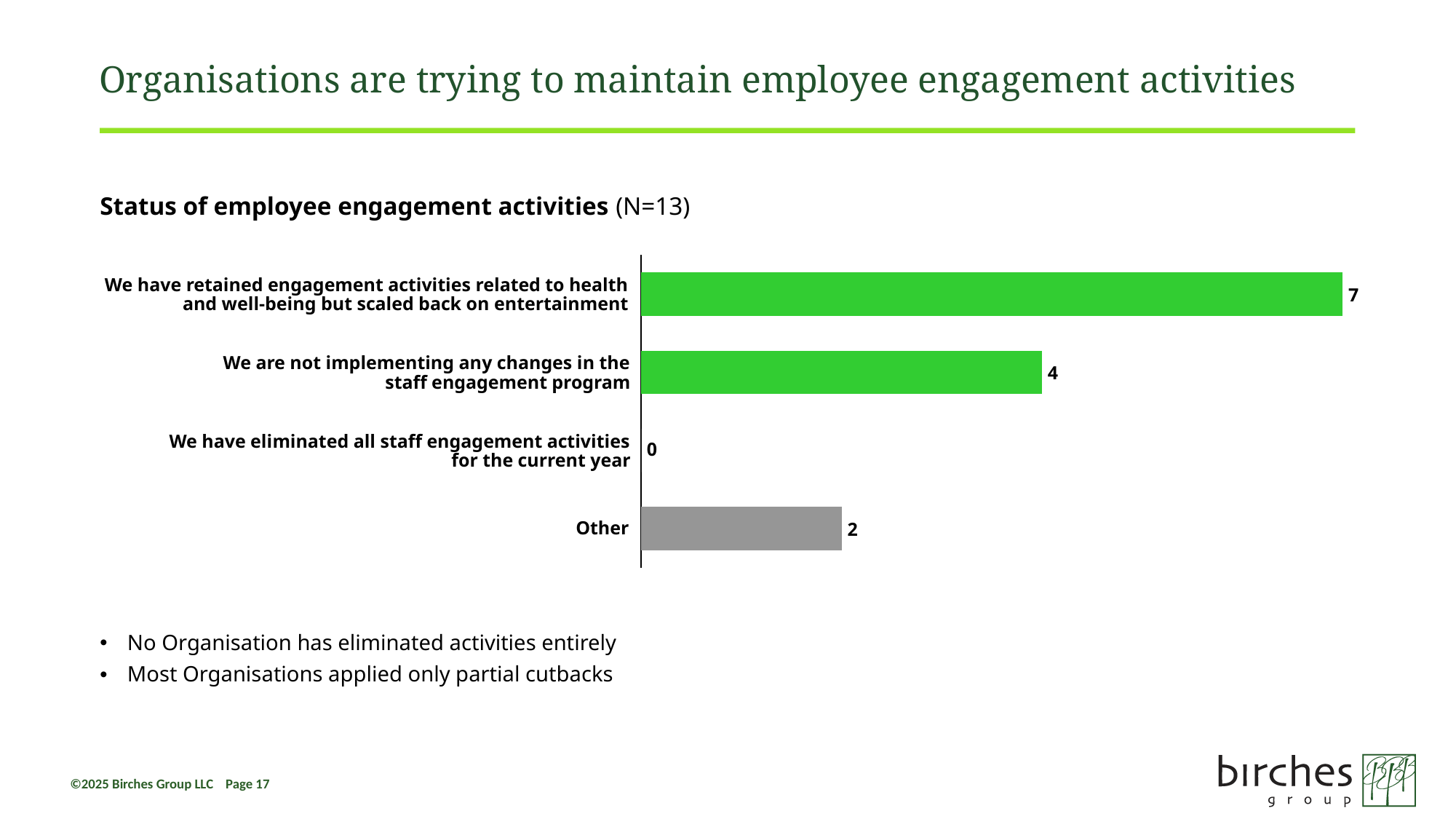
Which category has the lowest value? We have eliminated all staff engagement activities for the current year What is the value for "Other"? 2 How many categories are shown in the chart? 4 What is the value for "We are not implementing any changes in the staff engagement program"? 4 Which category has the highest value? We have retained engagement activities related to health and well-being but scaled back on entertainment What is the value for "We have eliminated all staff engagement activities for the current year"? 0 What is the value for "We have retained engagement activities related to health and well-being but scaled back on entertainment"? 7 What is the title of the chart? Status of employee engagement activities (N=13) What kind of chart is shown on the slide? Bar chart What is the difference between the value for "We have retained engagement activities related to health and well-being but scaled back on entertainment" and the value for "We are not implementing any changes in the staff engagement program"? 3 Which is larger: the value for "We are not implementing any changes in the staff engagement program" or the value for "Other"? We are not implementing any changes in the staff engagement program What colour is the bar for "Other"? Grey